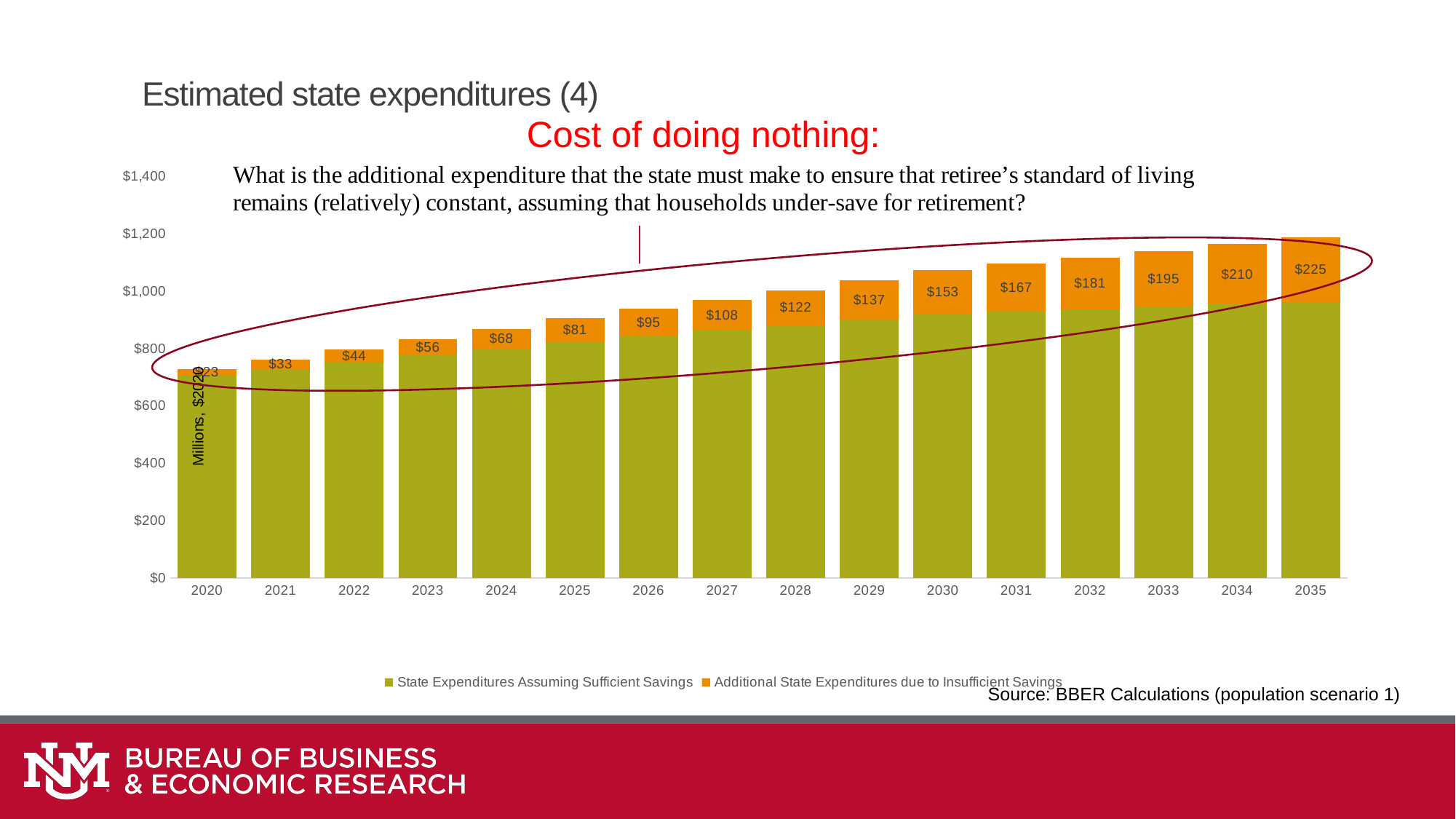
Which year has a larger Additional State Expenditures due to Insufficient Savings value, 2026 or 2031? 2031 What is the difference between the Additional State Expenditures due to Insufficient Savings in 2035 and in 2030? $72 Which year has the highest Additional State Expenditures due to Insufficient Savings? 2035 Do the Additional State Expenditures due to Insufficient Savings values rise or fall from 2020 to 2035? rise What is the value of Additional State Expenditures due to Insufficient Savings for 2035? $225 Which year has the lowest Additional State Expenditures due to Insufficient Savings? 2020 What is the value of Additional State Expenditures due to Insufficient Savings for 2028? $122 Is the total stacked bar value for 2035 greater or less than $1,000? greater What is the value of Additional State Expenditures due to Insufficient Savings for 2023? $56 Is the total stacked bar value for 2020 greater or less than $800? less How many series does the chart's legend list? 2 How many years are shown on the x axis of the chart? 16